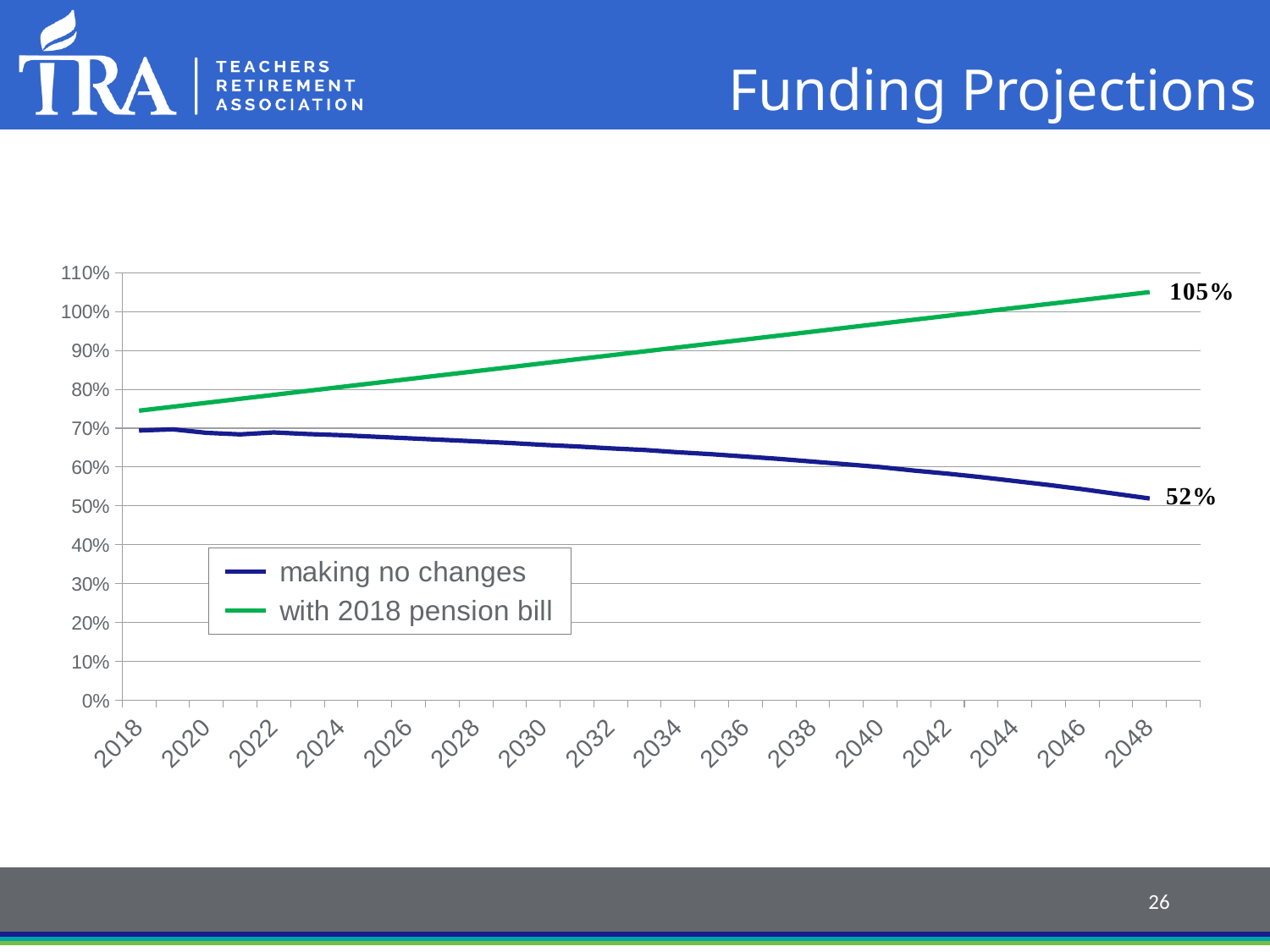
Is the value for 'making no changes' in 2018 greater or less than 60%? greater Is the value for 'with 2018 pension bill' in 2034 greater or less than 80%? greater Does the 'with 2018 pension bill' series rise or fall from 2018 to 2048? rise Is the value for 'making no changes' in 2040 greater or less than 70%? less What kind of chart is shown on the slide? line chart Which series has the higher value in 2048, 'making no changes' or 'with 2018 pension bill'? with 2018 pension bill Does the 'making no changes' series rise or fall from 2018 to 2048? fall What is the difference between the 'with 2018 pension bill' and 'making no changes' values in 2048? 53% What is the value for the 'with 2018 pension bill' series in 2048? 105% What is the value for the 'making no changes' series in 2048? 52% How many series does the legend list? 2